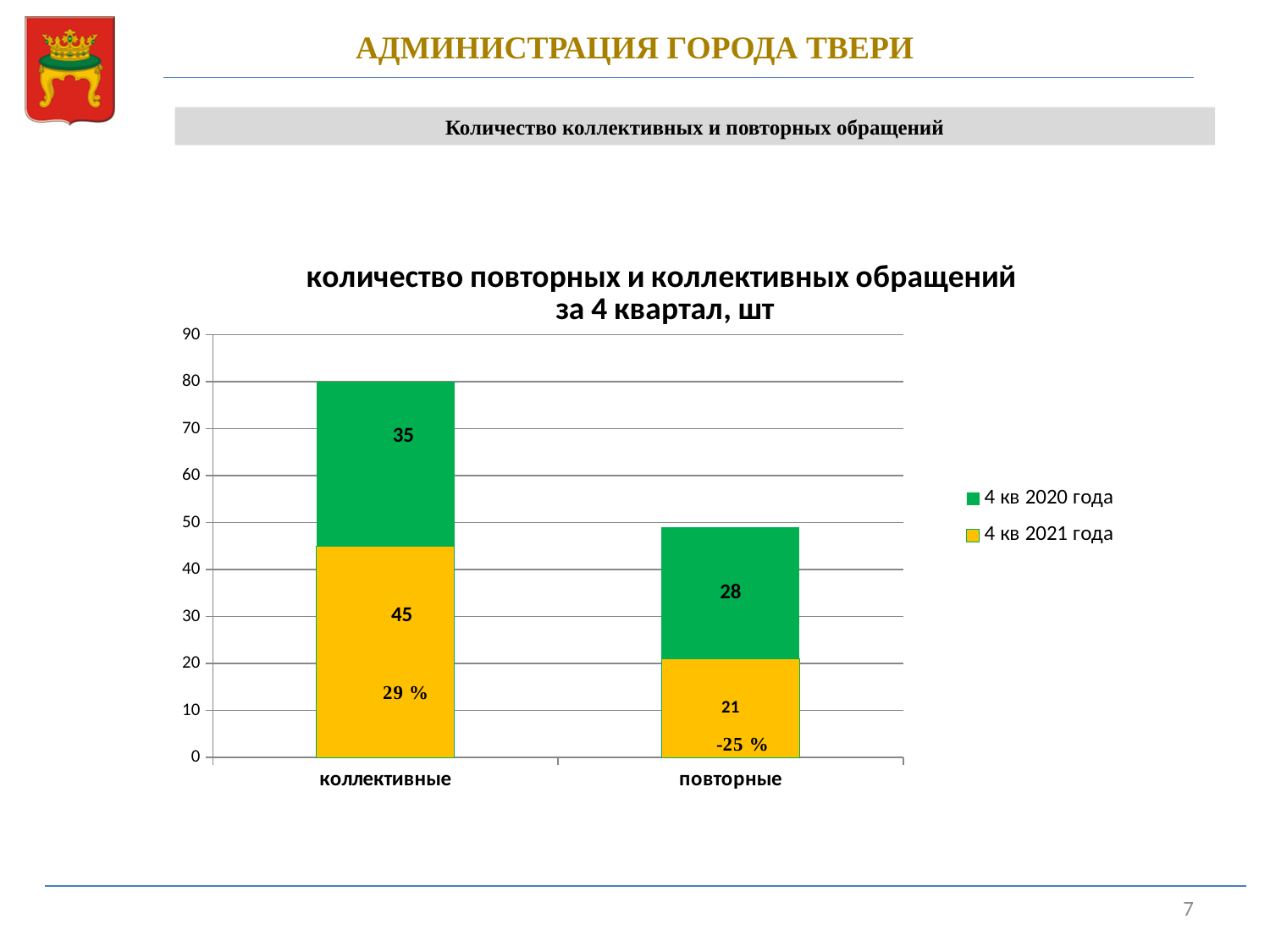
What is the value for 4 кв 2021 года in the повторные category? 21 Which is larger for повторные: the 4 кв 2020 года value or the 4 кв 2021 года value? 4 кв 2020 года What is the value for 4 кв 2021 года in the коллективные category? 45 What is the value for 4 кв 2020 года in the коллективные category? 35 What is the total of the stacked bar for повторные? 49 What is the value for 4 кв 2020 года in the повторные category? 28 What kind of chart is shown on the slide? Stacked bar chart How many series does the legend list? 2 What is the total of the stacked bar for коллективные? 80 What is the difference between the 4 кв 2021 года values for коллективные and повторные? 24 What percentage change label is shown on the повторные bar? -25 % How many categories are shown on the x axis? 2